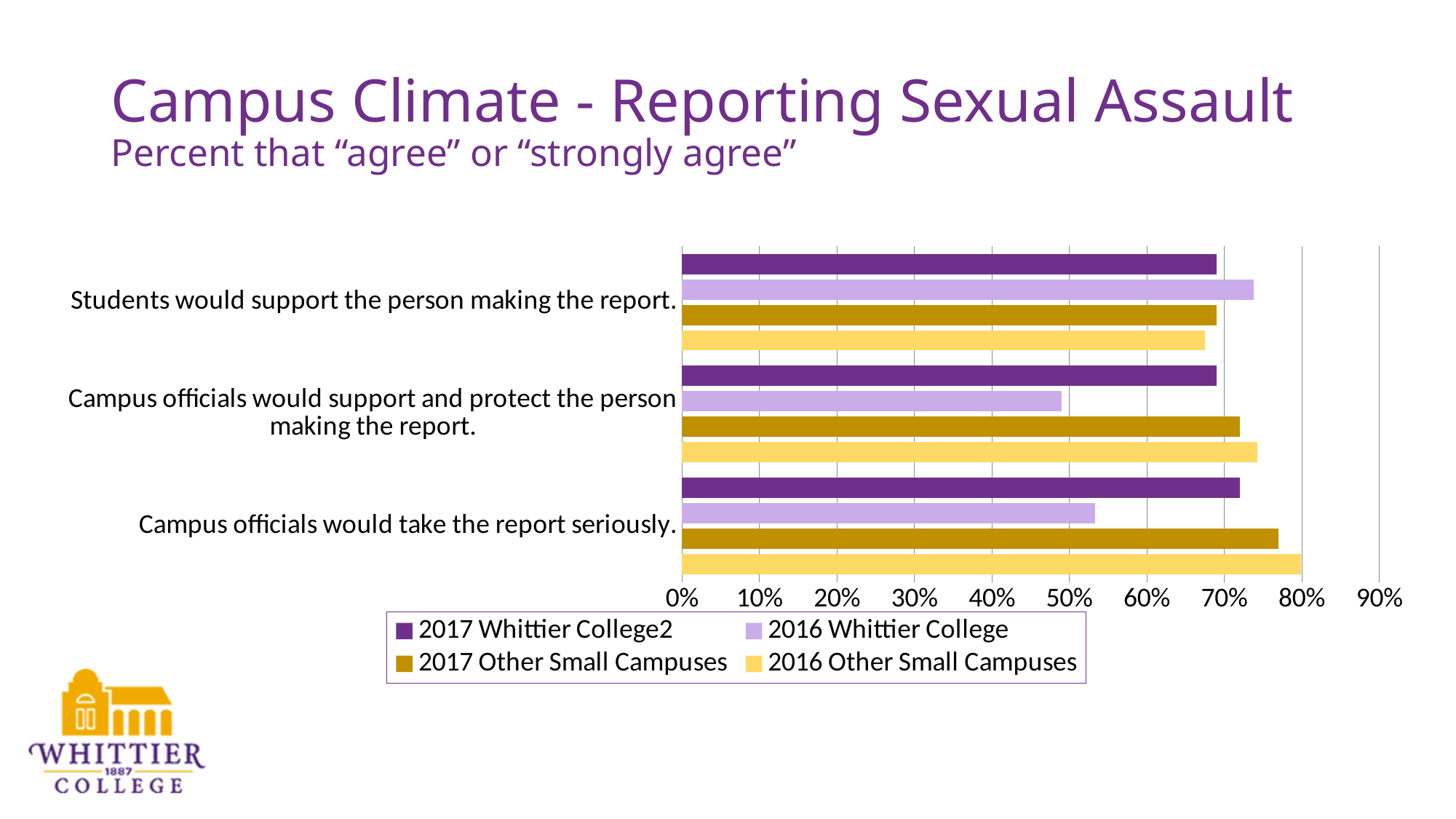
Is the 2016 Other Small Campuses value for "Campus officials would take the report seriously." greater or less than 70%? greater Which series has the highest value for "Students would support the person making the report."? 2016 Whittier College For "Campus officials would take the report seriously.", which is larger: the 2016 Other Small Campuses value or the 2016 Whittier College value? 2016 Other Small Campuses Which series has the lowest value for "Campus officials would take the report seriously."? 2016 Whittier College Is the 2016 Whittier College value for "Campus officials would support and protect the person making the report." greater or less than 60%? less How many series does the legend list? 4 What kind of chart is shown on the slide? bar chart Is the 2016 Whittier College value for "Campus officials would take the report seriously." greater or less than 60%? less How many statement categories are plotted on the chart? 3 For "Campus officials would support and protect the person making the report.", which is larger: the 2017 Whittier College2 value or the 2016 Whittier College value? 2017 Whittier College2 What is the subtitle under the slide title? Percent that "agree" or "strongly agree"